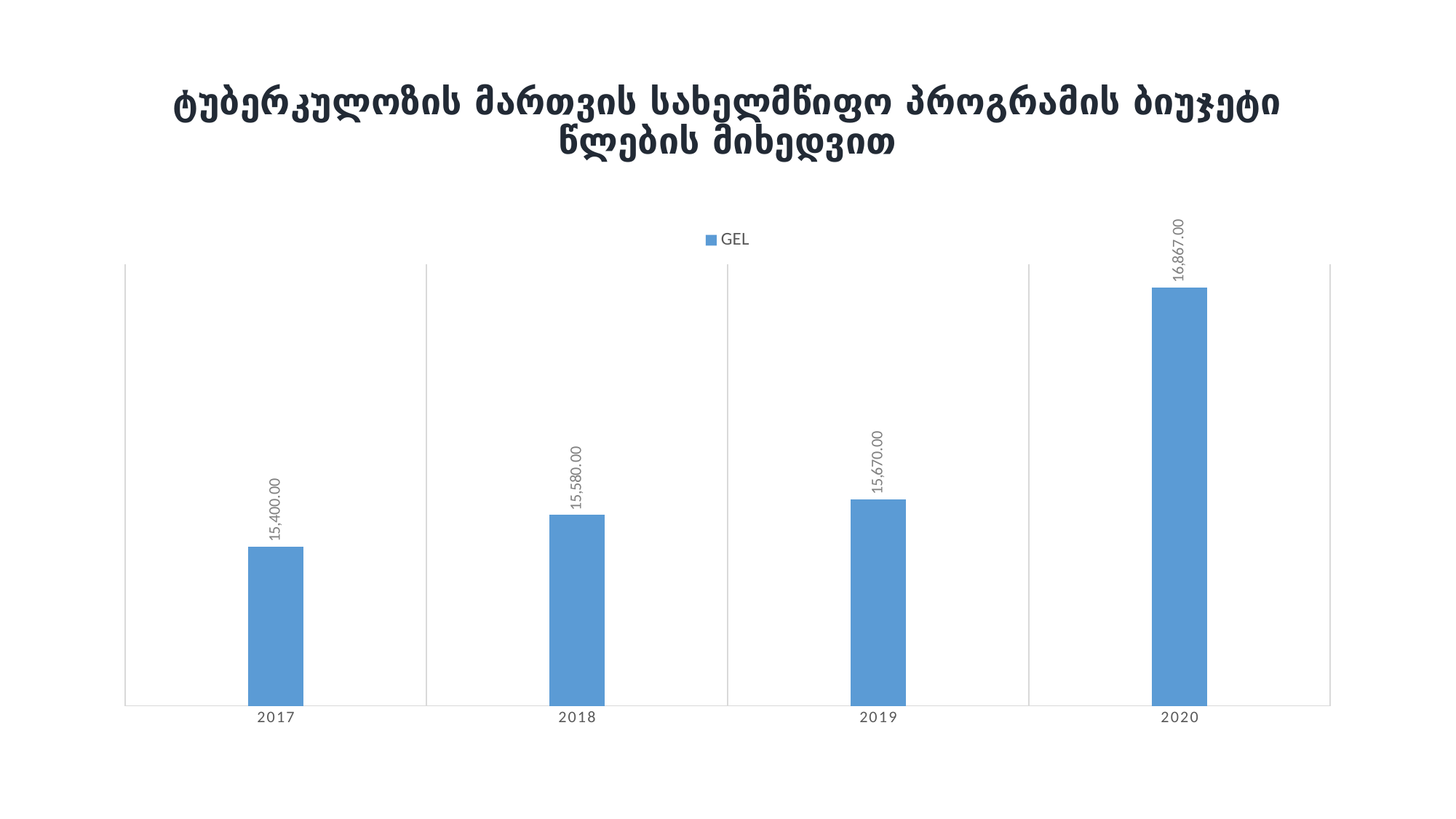
What is the value for 2017? 15,400.00 How many years are shown on the x axis? 4 What is the difference between the values for 2018 and 2017? 180.00 What is the value for 2020? 16,867.00 Which year has the lowest value? 2017 What kind of chart is shown on the slide? Bar chart What is the value for 2018? 15,580.00 How many series does the legend list? 1 What is the value for 2019? 15,670.00 What is the difference between the values for 2020 and 2019? 1,197.00 Which year has the highest value? 2020 Which is larger, the value for 2019 or the value for 2018? 2019